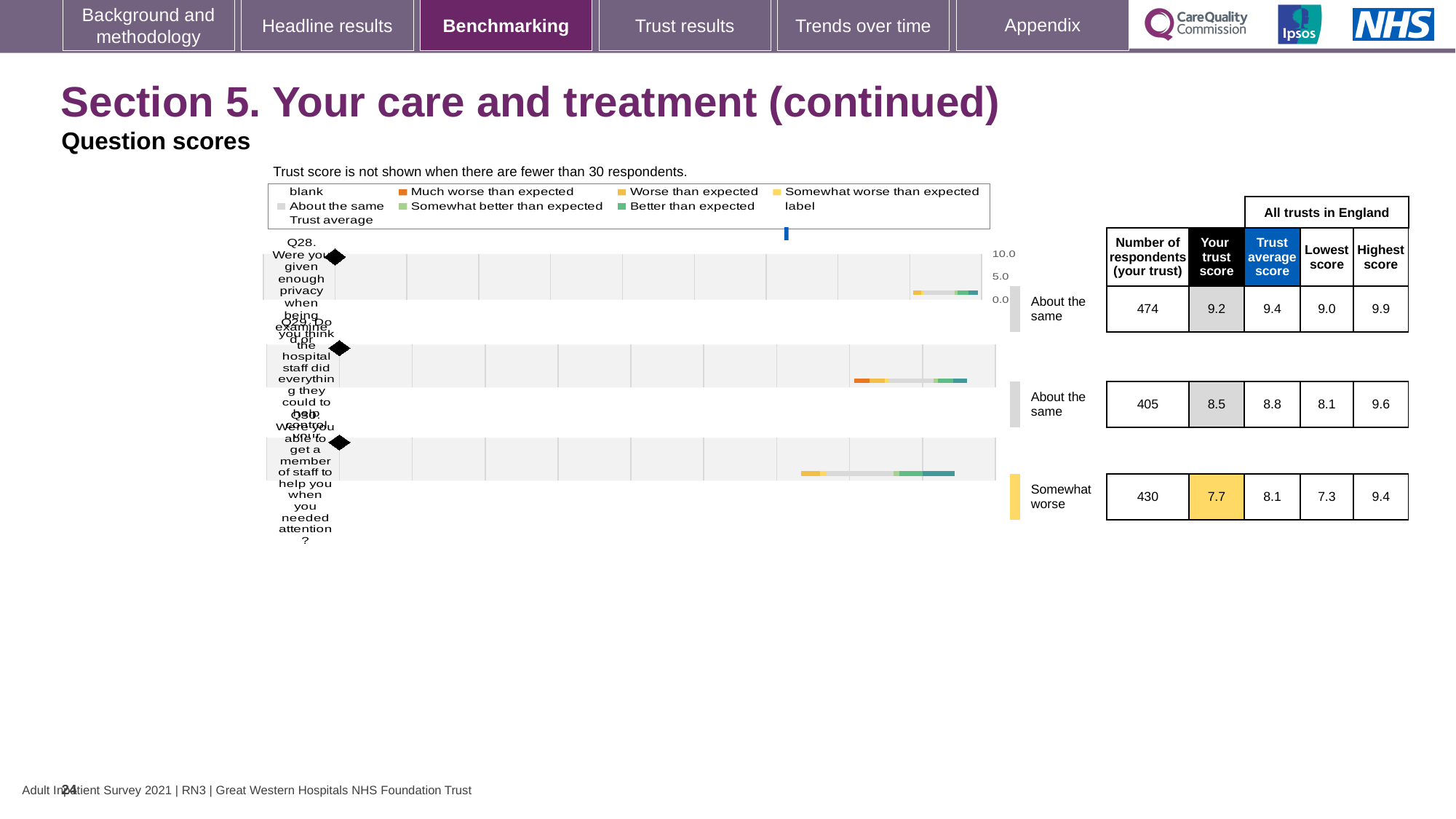
How many respondents answered Q29 at this trust? 405 What is the difference between the trust average score and this trust's score for Q30? 0.4 What is the trust score for Q28? 9.2 Which question has the highest trust score? Q28 Which question has the lowest trust score? Q30 What is the highest score among all trusts in England for Q29? 9.6 Which has the larger trust score, Q28 or Q29? Q28 What benchmark category is Q30 placed in? Somewhat worse What kind of chart is used to show the question scores? Bar chart How many questions are shown in the chart? 3 What is the trust average score for Q30? 8.1 According to the note above the chart, when is the trust score not shown? When there are fewer than 30 respondents